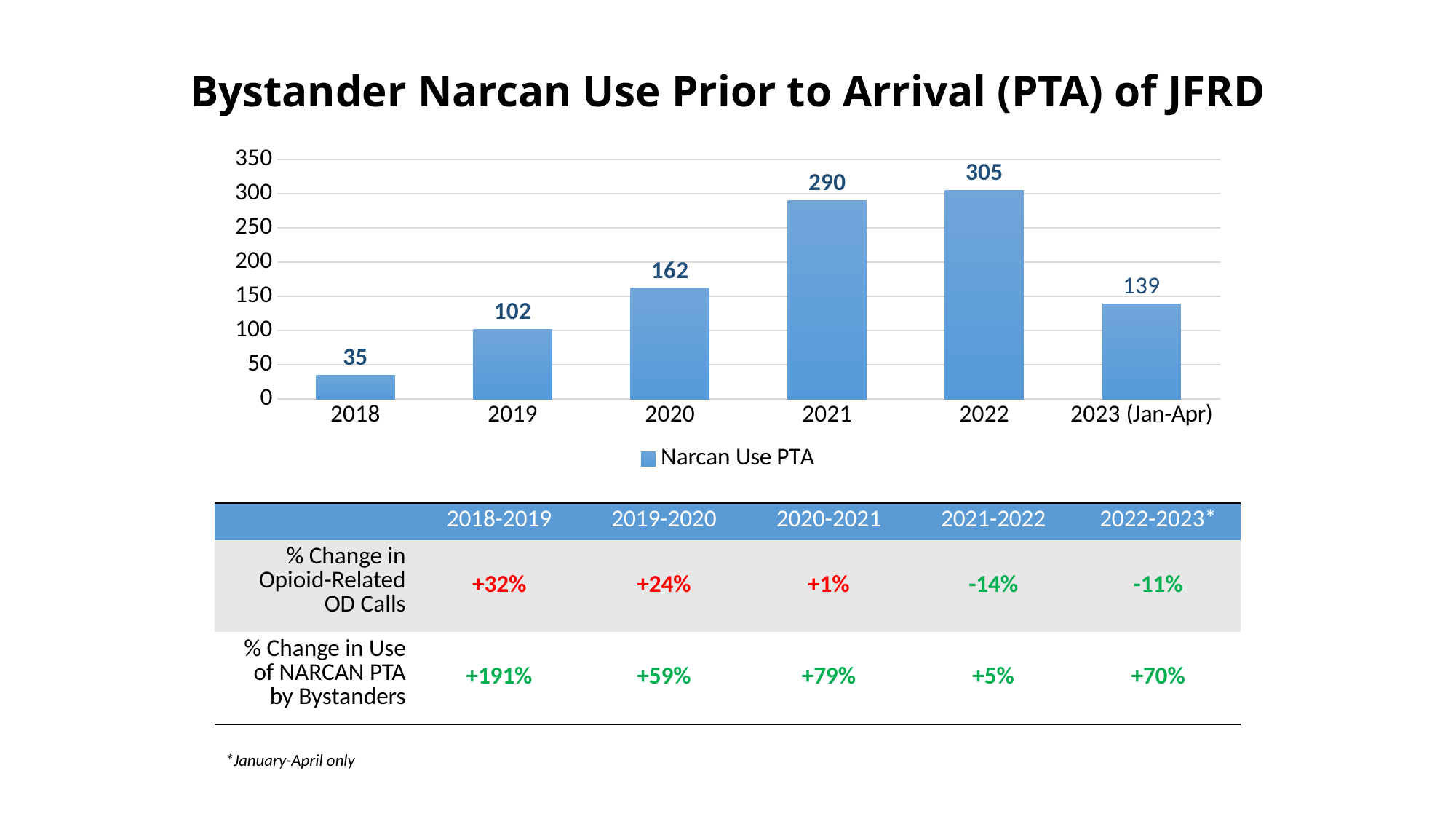
What is the Narcan Use PTA value for 2021? 290 What is the Narcan Use PTA value for 2023 (Jan-Apr)? 139 What is the Narcan Use PTA value for 2018? 35 What is the difference between the Narcan Use PTA values for 2022 and 2021? 15 What kind of chart is shown on the slide? bar chart Which year has the highest Narcan Use PTA value? 2022 Is the Narcan Use PTA value for 2021 greater or less than 250? greater What is the difference between the Narcan Use PTA values for 2020 and 2019? 60 Which year has the lowest Narcan Use PTA value? 2018 What is the legend entry for the series in the chart? Narcan Use PTA Which is larger, the Narcan Use PTA value for 2020 or for 2023 (Jan-Apr)? 2020 How many categories are shown on the x axis of the chart? 6